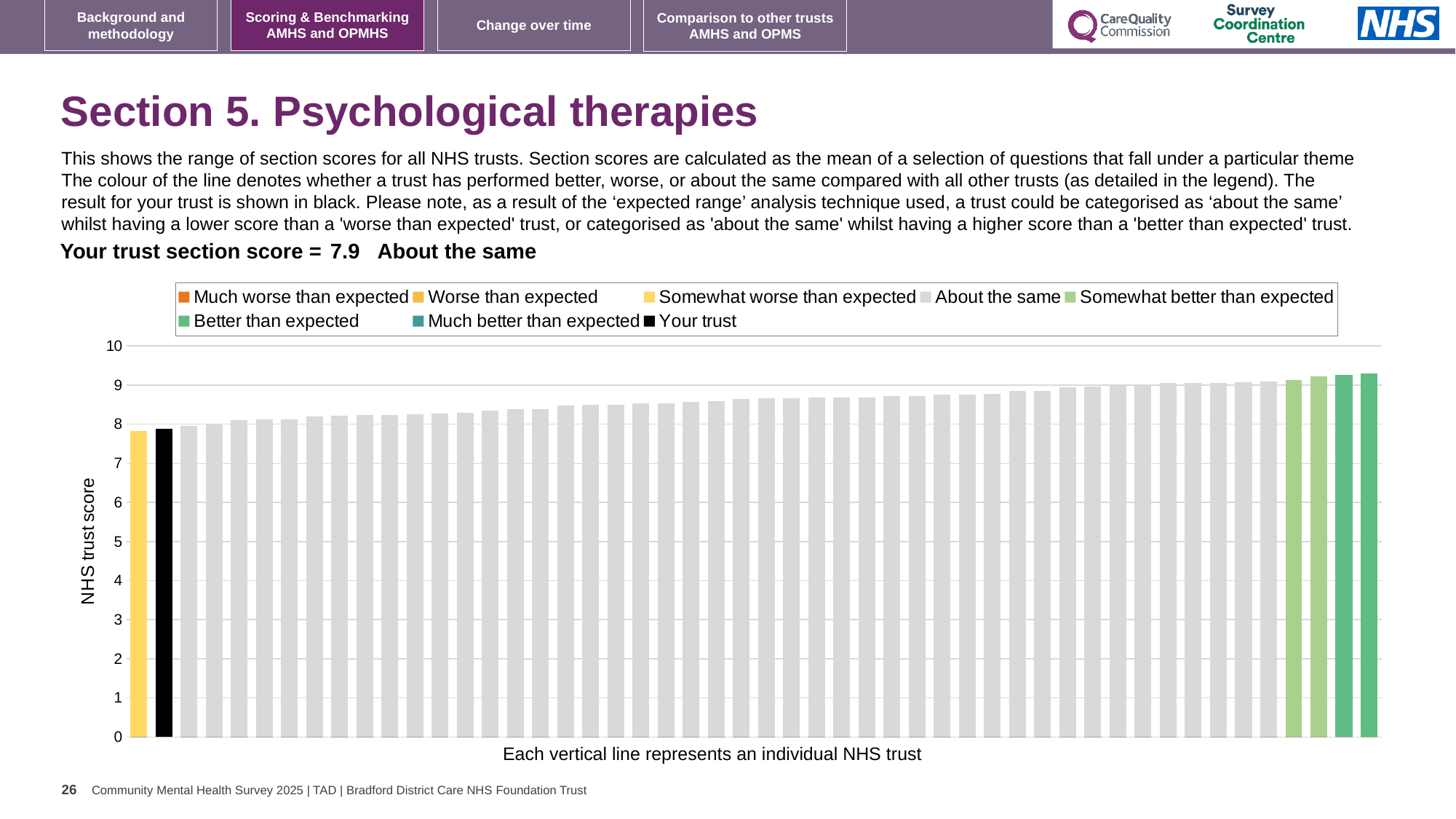
Is the value of the rightmost bar greater or less than 9? greater Is the value of the black 'Your trust' bar greater or less than 5? greater What type of chart is shown on the slide? bar chart Which category is your trust placed in for this section? About the same What is the section score for your trust shown on the slide? 7.9 Do the bar values rise or fall from left to right along the x axis? rise Which bar is the tallest: the leftmost bar or the rightmost bar? rightmost bar How many entries does the chart legend list? 8 What colour is the bar representing your trust? black What is the label on the vertical axis of the chart? NHS trust score How many bars are coloured in the darker green 'Better than expected' colour? 2 Is the value of the leftmost bar greater or less than 7? greater